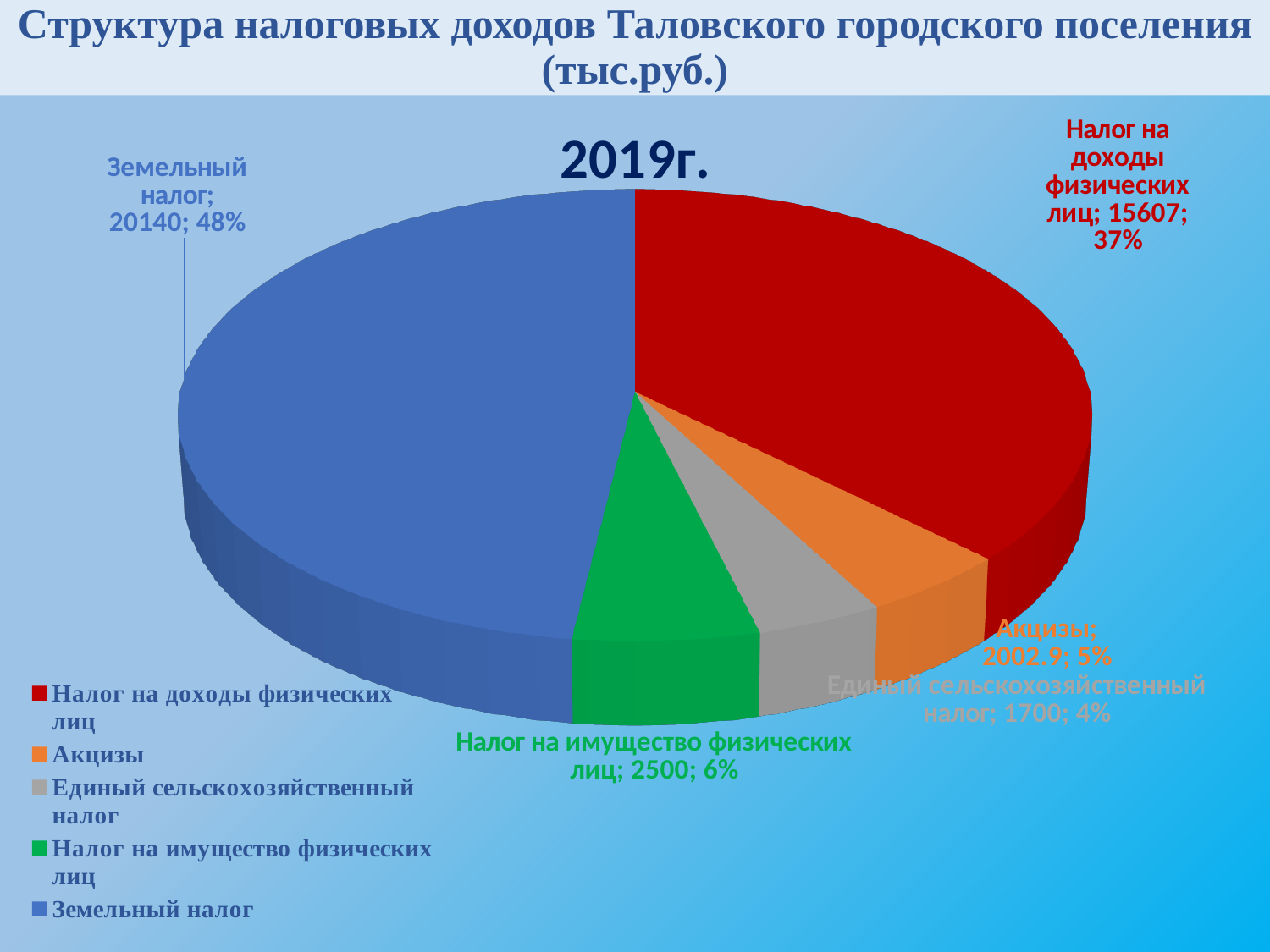
What is the value for Акцизы? 2002.9 What is the value for Единый сельскохозяйственный налог? 1700 What is the difference between the values for Земельный налог and Налог на доходы физических лиц? 4533 How many categories does the legend list? 5 What share of the pie does Земельный налог represent? 48% What is the value for Земельный налог in the 2019г. pie chart? 20140 What kind of chart is shown on the slide? Pie chart Which is larger, the value for Налог на имущество физических лиц or the value for Акцизы? Налог на имущество физических лиц What is the value for Налог на доходы физических лиц? 15607 Which category has the largest slice of the pie? Земельный налог Which category has the smallest slice of the pie? Единый сельскохозяйственный налог What share of the pie does Налог на имущество физических лиц represent? 6%